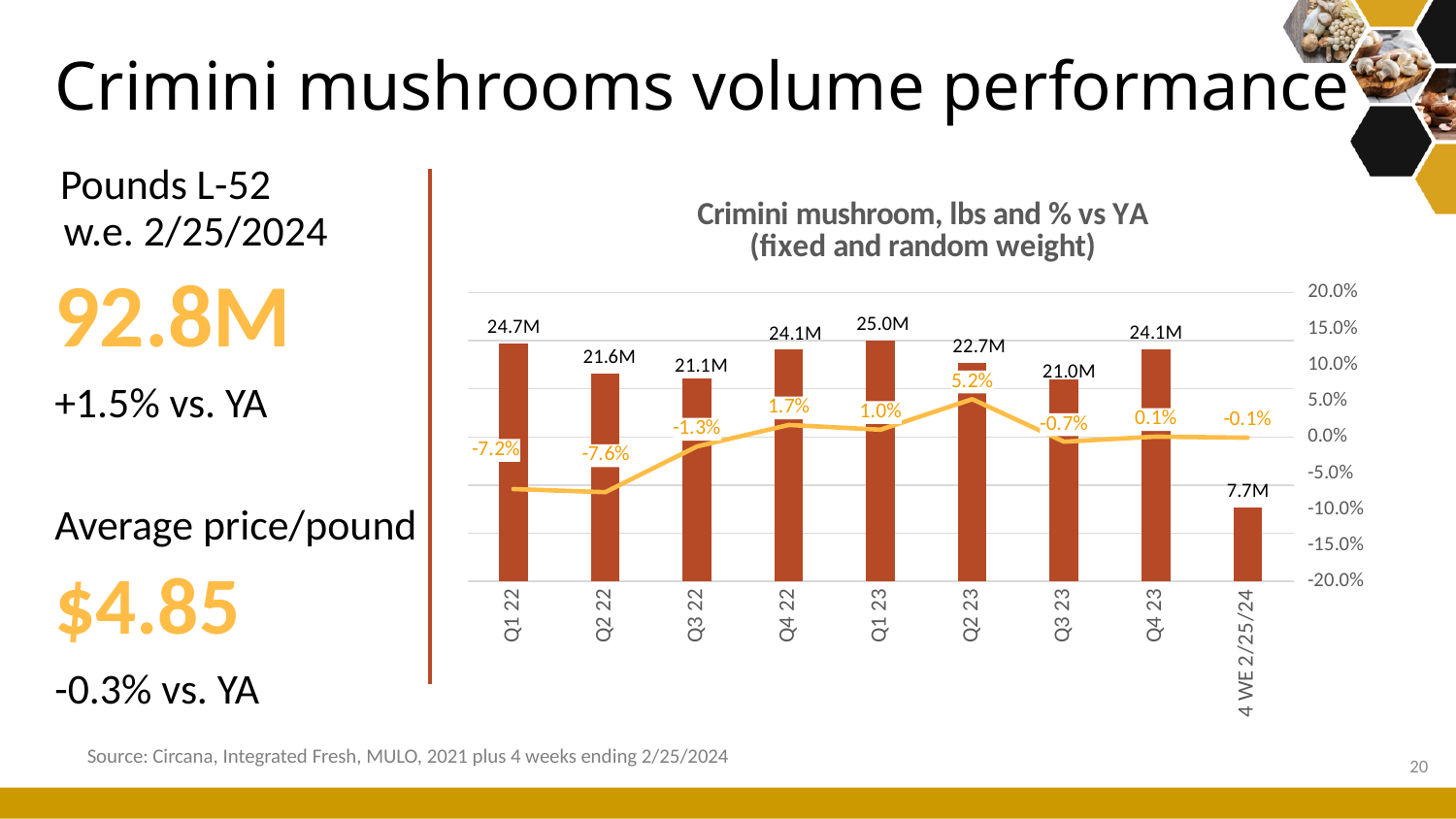
What kind of chart is shown? Combined bar and line chart What is the % vs YA value for Q2 23? 5.2% Does the % vs YA line rise or fall from Q2 22 to Q2 23? Rise What is the % vs YA value for Q2 22? -7.6% What is the volume in pounds for the 4 WE 2/25/24 period? 7.7M What is the difference in pounds between Q1 22 and Q2 22? 3.2M What is the volume in pounds for Q1 23? 25.0M Which period has the lowest % vs YA value? Q2 22 Which has a higher volume in pounds, Q4 22 or Q2 23? Q4 22 What is the title of the chart? Crimini mushroom, lbs and % vs YA (fixed and random weight) Which period has the highest volume in pounds? Q1 23 How many periods are shown on the x axis? 9